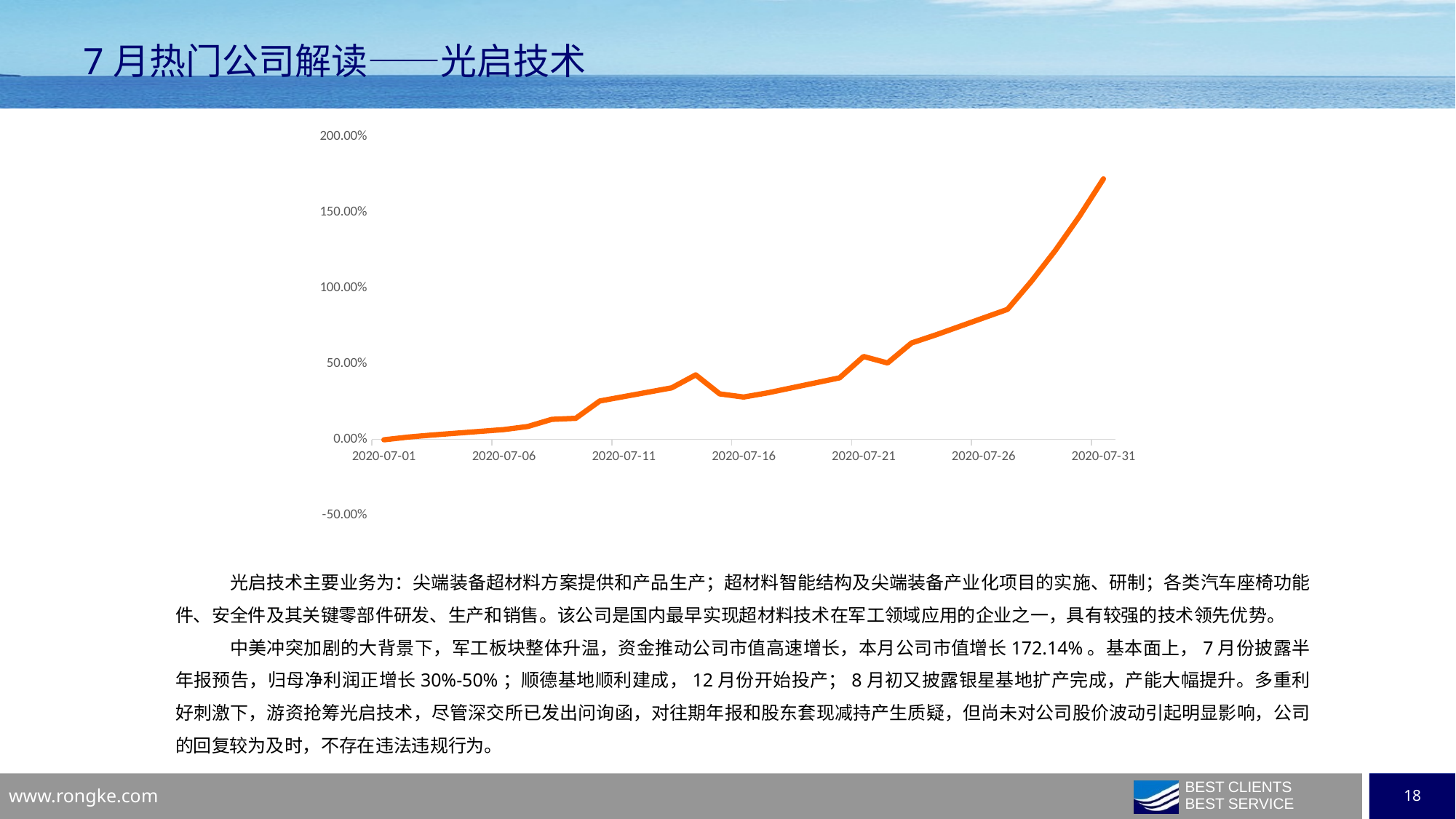
On which date is the line at its lowest value? 2020-07-01 Overall, does the line rise or fall from 2020-07-01 to 2020-07-31? rise What is the highest tick label shown on the vertical axis? 200.00% On which date does the line reach its highest value? 2020-07-31 Is the value at 2020-07-16 greater or less than 50.00%? less What colour is the line in the chart? orange Is the value at 2020-07-06 greater or less than 50.00%? less Is the value at 2020-07-31 greater or less than 150.00%? greater Which date has the larger value, 2020-07-01 or 2020-07-31? 2020-07-31 What kind of chart is shown on the slide? line chart